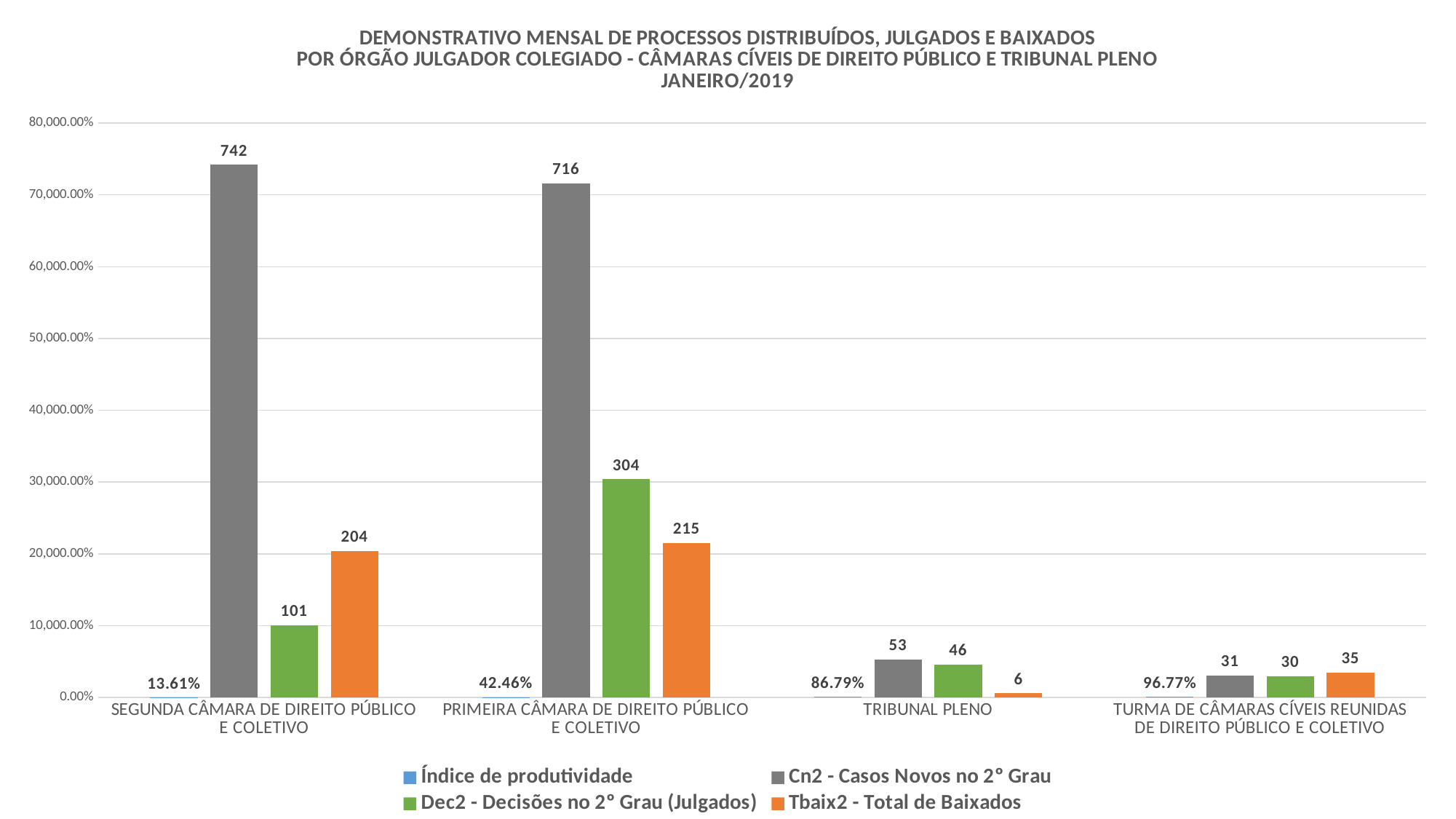
How many series does the legend list? 4 What is the value of Cn2 - Casos Novos no 2° Grau for SEGUNDA CÂMARA DE DIREITO PÚBLICO E COLETIVO? 742 What is the value of Tbaix2 - Total de Baixados for TURMA DE CÂMARAS CÍVEIS REUNIDAS DE DIREITO PÚBLICO E COLETIVO? 35 What is the value of Dec2 - Decisões no 2° Grau (Julgados) for PRIMEIRA CÂMARA DE DIREITO PÚBLICO E COLETIVO? 304 What is the difference between Dec2 - Decisões no 2° Grau (Julgados) and Tbaix2 - Total de Baixados for SEGUNDA CÂMARA DE DIREITO PÚBLICO E COLETIVO? 103 Which category has the lowest value for Tbaix2 - Total de Baixados? TRIBUNAL PLENO Which is larger for TRIBUNAL PLENO: Cn2 - Casos Novos no 2° Grau or Dec2 - Decisões no 2° Grau (Julgados)? Cn2 - Casos Novos no 2° Grau Which category has the highest value for Cn2 - Casos Novos no 2° Grau? SEGUNDA CÂMARA DE DIREITO PÚBLICO E COLETIVO What kind of chart is shown on the slide? Bar chart What is the Índice de produtividade for TRIBUNAL PLENO? 86.79% How many categories (órgãos julgadores) are shown on the x axis? 4 What is the difference between the Cn2 - Casos Novos no 2° Grau values for SEGUNDA CÂMARA and PRIMEIRA CÂMARA DE DIREITO PÚBLICO E COLETIVO? 26